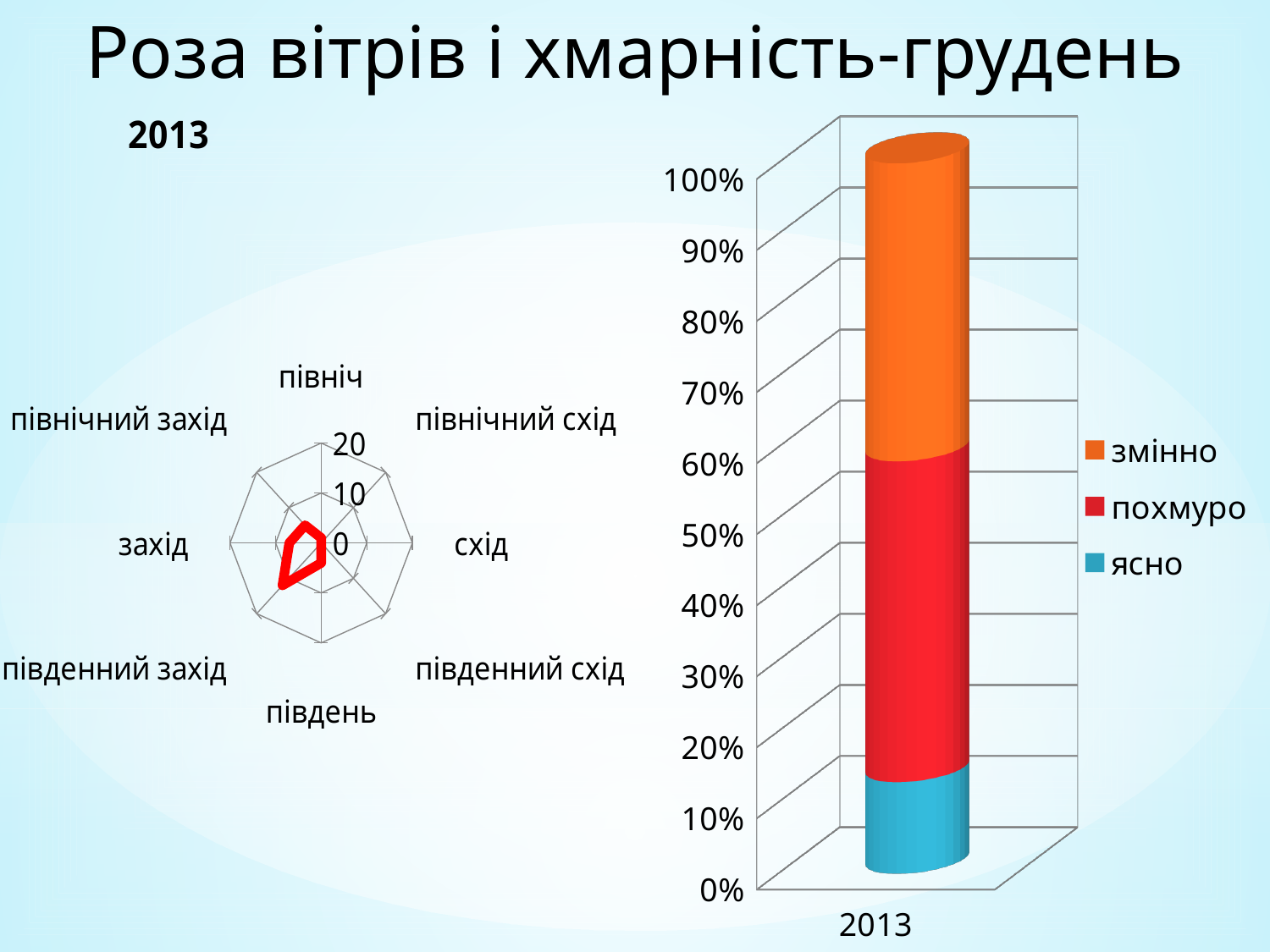
How many directions (categories) are shown on the left-hand radar chart? 8 What category label appears on the x axis of the right-hand bar chart? 2013 What kind of chart is the chart on the right side of the slide? bar chart What kind of chart is the chart on the left side of the slide (titled 2013)? radar chart In the right-hand bar chart, which is larger for 2013: похмуро or ясно? похмуро In the right-hand bar chart, is the value for змінно in 2013 greater or less than 30%? greater What are the legend entries of the right-hand bar chart? змінно, похмуро, ясно How many series does the legend of the right-hand bar chart list? 3 In the right-hand bar chart, which is larger for 2013: змінно or ясно? змінно In the left-hand radar chart, which direction has the highest value? південний захід In the right-hand bar chart, is the value for ясно in 2013 greater or less than 30%? less In the right-hand bar chart, is the value for похмуро in 2013 greater or less than 30%? greater